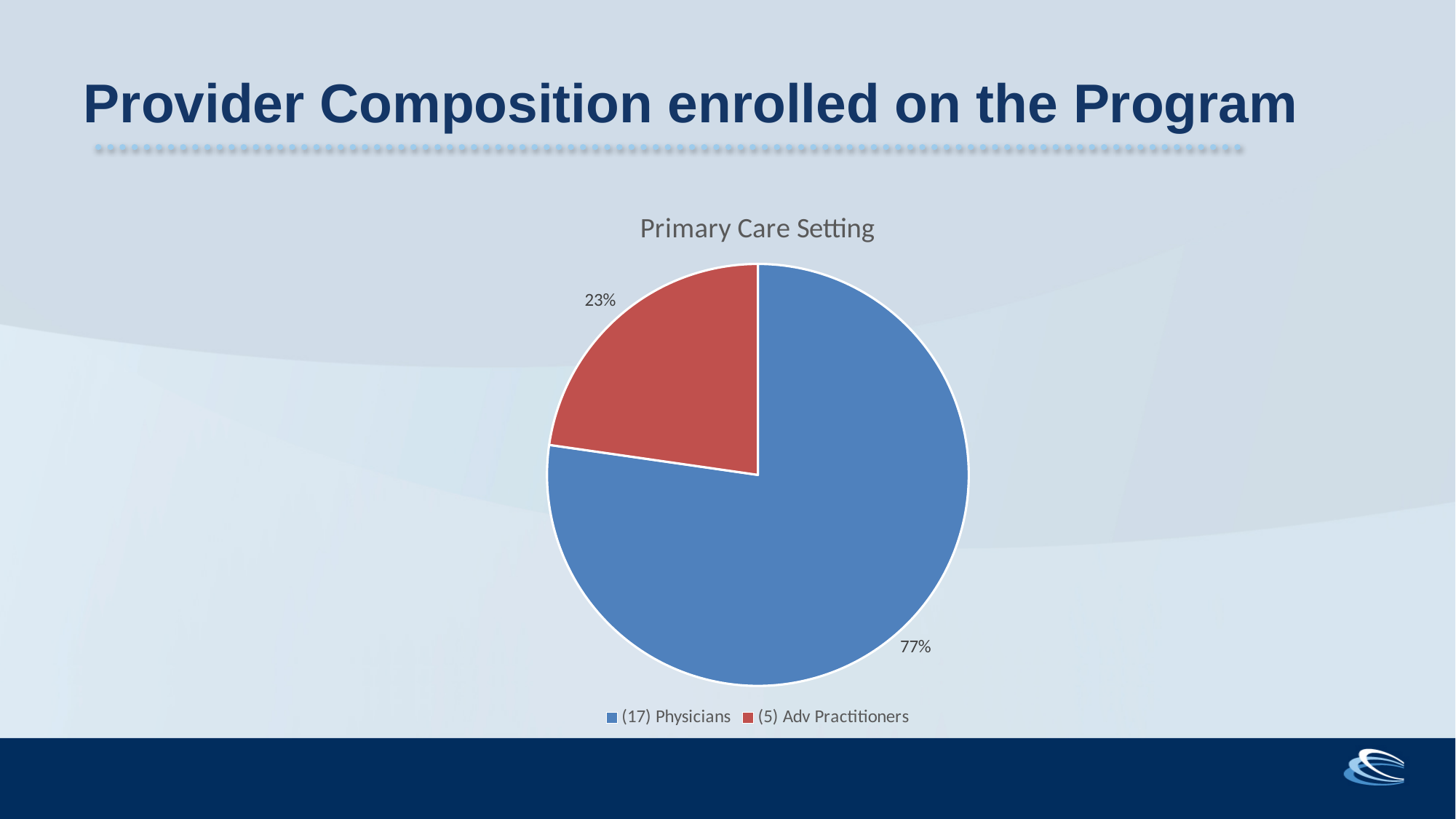
What percentage of the pie is labelled for Physicians? 77% Which is larger, the Physicians slice or the Adv Practitioners slice? Physicians What is the difference in percentage points between the Physicians slice and the Adv Practitioners slice? 54 What is the title of the chart? Primary Care Setting Which category has the largest share of the pie? (17) Physicians How many entries does the legend list? 2 How many slices does the pie chart have? 2 How many Physicians are indicated in the legend? 17 What colour is the Adv Practitioners slice? red Which category has the smallest share of the pie? (5) Adv Practitioners What type of chart is shown on the slide? pie chart What percentage of the pie is labelled for Adv Practitioners? 23%